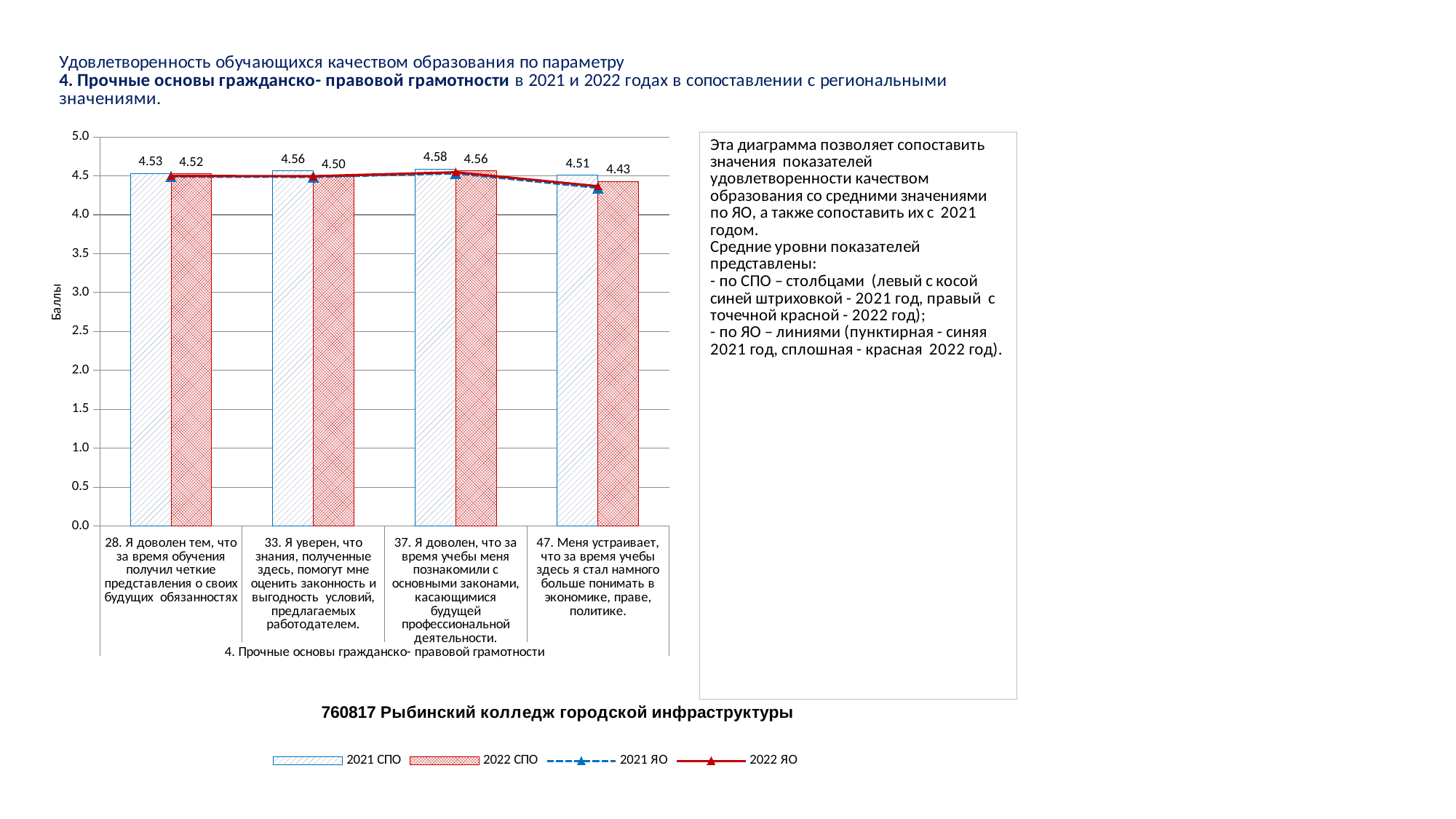
What is the 2022 СПО value for category 33 (Я уверен, что знания, полученные здесь, помогут мне оценить законность и выгодность условий, предлагаемых работодателем)? 4.50 What is the difference between the 2021 СПО and 2022 СПО values for category 47? 0.08 What is the label of the y axis? Баллы Which is larger for category 37: the 2021 СПО value or the 2022 СПО value? 2021 СПО Is the 2022 ЯО line value for category 47 greater or less than 4.0? greater What is the 2022 СПО value for category 47 (Меня устраивает, что за время учебы здесь я стал намного больше понимать в экономике, праве, политике)? 4.43 How many categories (questions) are shown on the x axis? 4 Which category has the highest 2021 СПО value? 37. Я доволен, что за время учебы меня познакомили с основными законами, касающимися будущей профессиональной деятельности. What kind of chart is shown on the slide? Combined bar and line chart What is the 2021 СПО value for category 28 (Я доволен тем, что за время обучения получил четкие представления о своих будущих обязанностях)? 4.53 How many series does the legend list? 4 Which category has the lowest 2022 СПО value? 47. Меня устраивает, что за время учебы здесь я стал намного больше понимать в экономике, праве, политике.